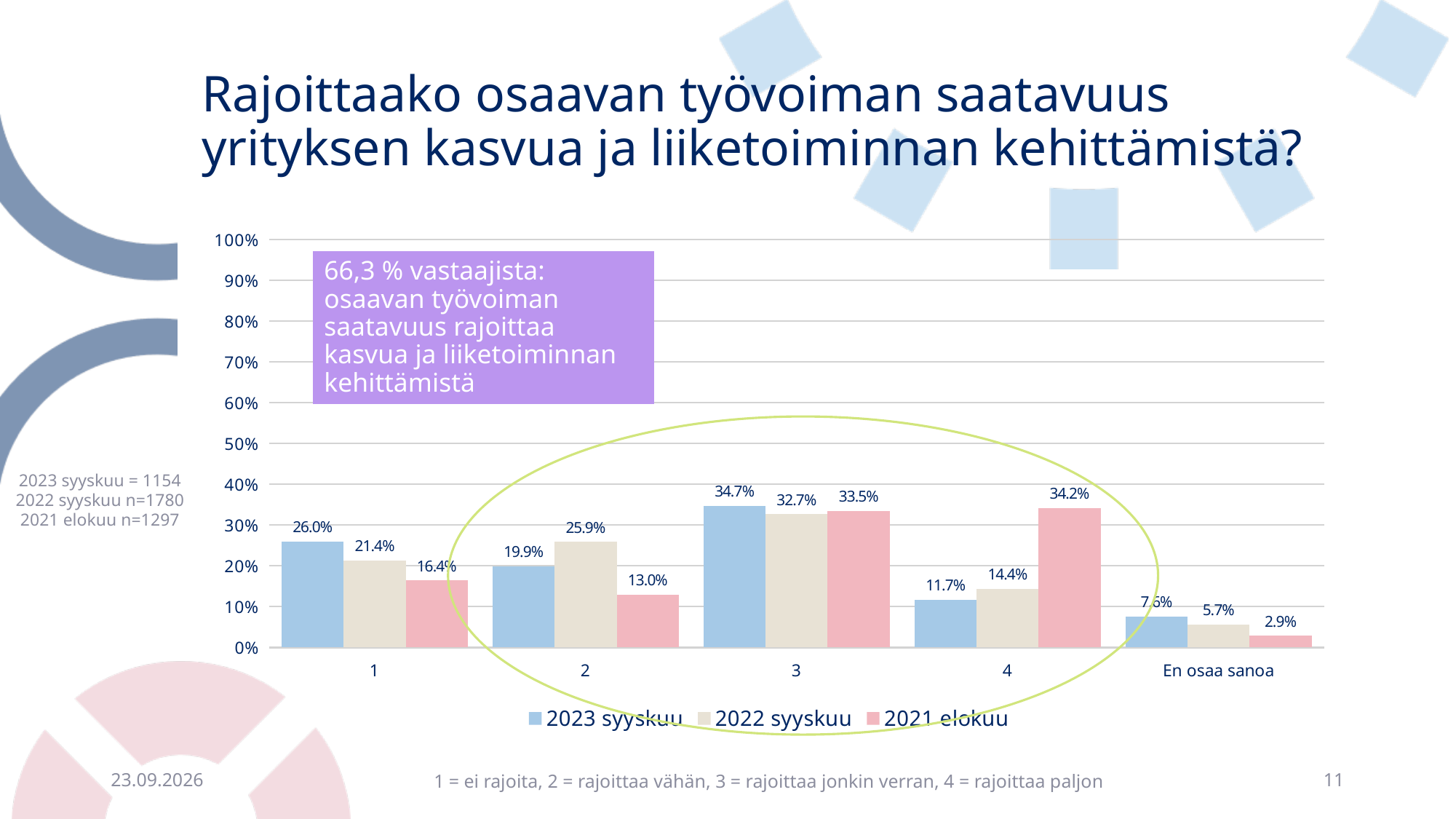
Which category has the highest value in the 2023 syyskuu series? 3 What is the value for En osaa sanoa in the 2022 syyskuu series? 5.7% How many series does the legend list? 3 Which category has the lowest value in the 2021 elokuu series? En osaa sanoa Which series is shown in pink in the legend? 2021 elokuu What is the difference between the 2022 syyskuu and 2021 elokuu values for category 2? 12.9% What is the value for category 1 in the 2023 syyskuu series? 26.0% For category 4, which series has the larger value: 2023 syyskuu or 2021 elokuu? 2021 elokuu What kind of chart is shown on the slide? bar chart Is the value for category 3 in the 2022 syyskuu series greater or less than 30%? greater How many categories are shown on the x axis? 5 What is the value for category 4 in the 2021 elokuu series? 34.2%